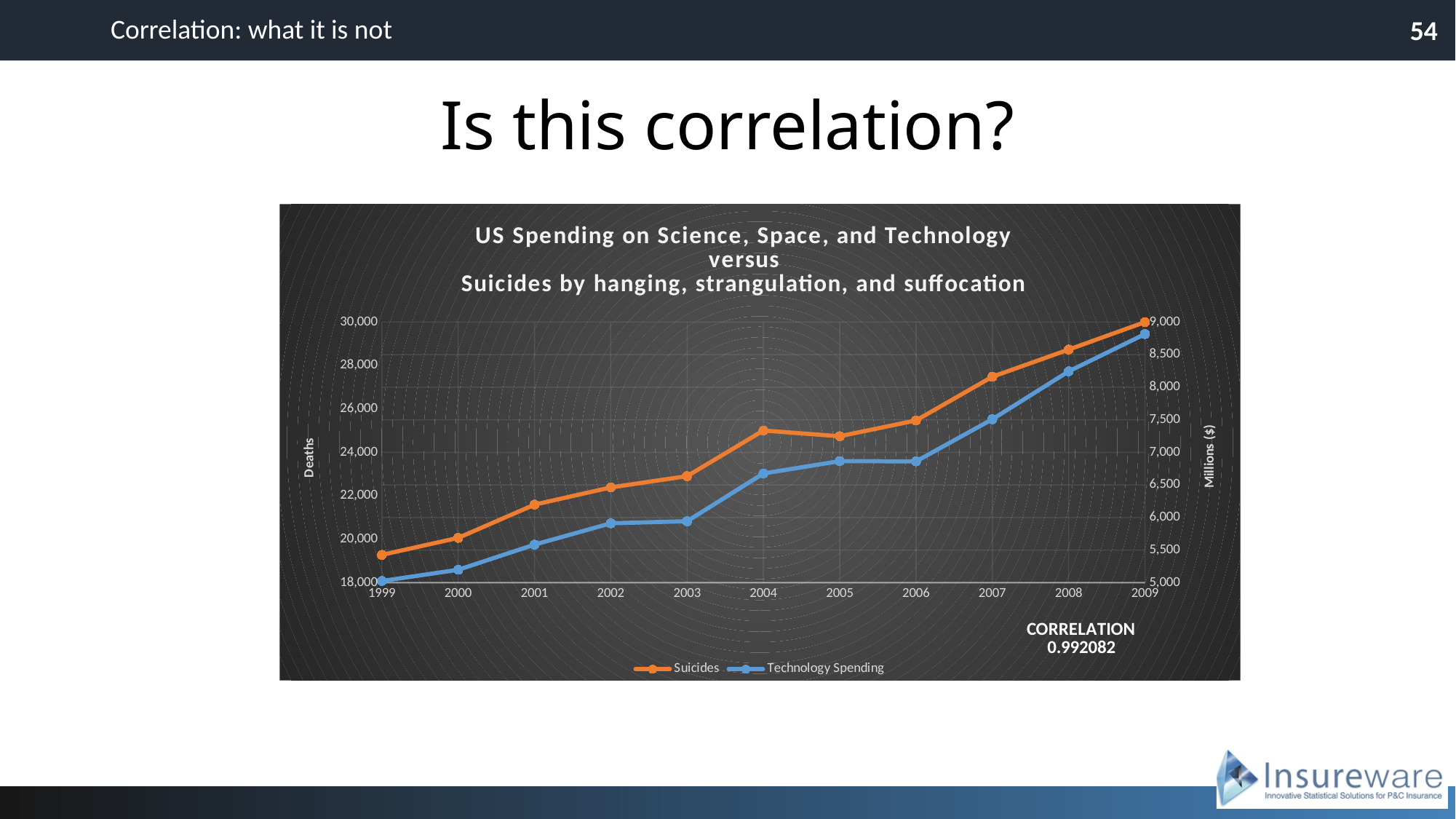
What is the label of the left vertical axis? Deaths How many series does the legend list? 2 In which year is the Suicides series at its highest? 2009 In which year is the Technology Spending series at its lowest? 1999 Is the Technology Spending value for 2006 greater or less than 6,500? greater How many years are plotted along the x axis? 11 Do the Suicides values generally rise or fall from 1999 to 2009? rise Is the Technology Spending value for 2009 greater or less than 8,500? greater What correlation value is printed on the chart? 0.992082 Is the Suicides value for 1999 greater or less than 20,000? less What kind of chart is shown on the slide? line chart